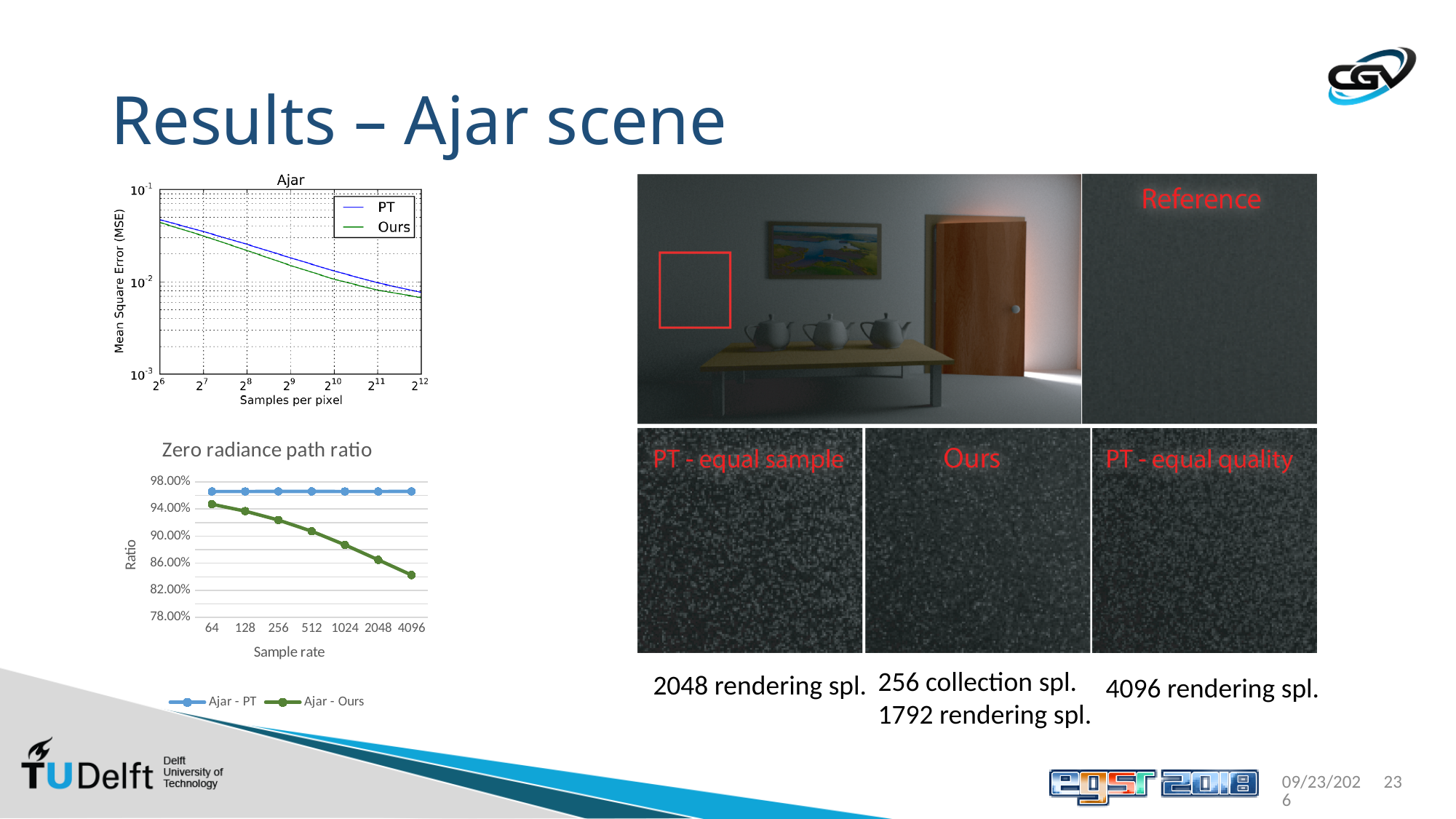
In the 'Ajar' MSE chart, does the mean square error rise or fall as samples per pixel increase? fall What is the x-axis label of the 'Ajar' MSE chart? Samples per pixel In the 'Ajar' MSE chart, which series has the higher mean square error at 2^12 samples per pixel, PT or Ours? PT In the 'Zero radiance path ratio' chart, which series is higher at a sample rate of 4096, 'Ajar - PT' or 'Ajar - Ours'? Ajar - PT In the 'Zero radiance path ratio' chart, is the value for 'Ajar - Ours' at sample rate 4096 greater or less than 86.00%? less In the 'Zero radiance path ratio' chart, is the value for 'Ajar - Ours' at sample rate 2048 greater or less than 90.00%? less In the 'Zero radiance path ratio' chart, how many series does the legend list? 2 In the 'Ajar' MSE chart, how many series does the legend list? 2 In the 'Zero radiance path ratio' chart, is the value for 'Ajar - PT' at sample rate 64 greater or less than 94.00%? greater In the 'Zero radiance path ratio' chart, how many sample rate categories are shown on the x axis? 7 In the 'Zero radiance path ratio' chart, does the 'Ajar - Ours' series rise or fall as the sample rate increases? fall What kind of chart is the 'Zero radiance path ratio' chart? line chart